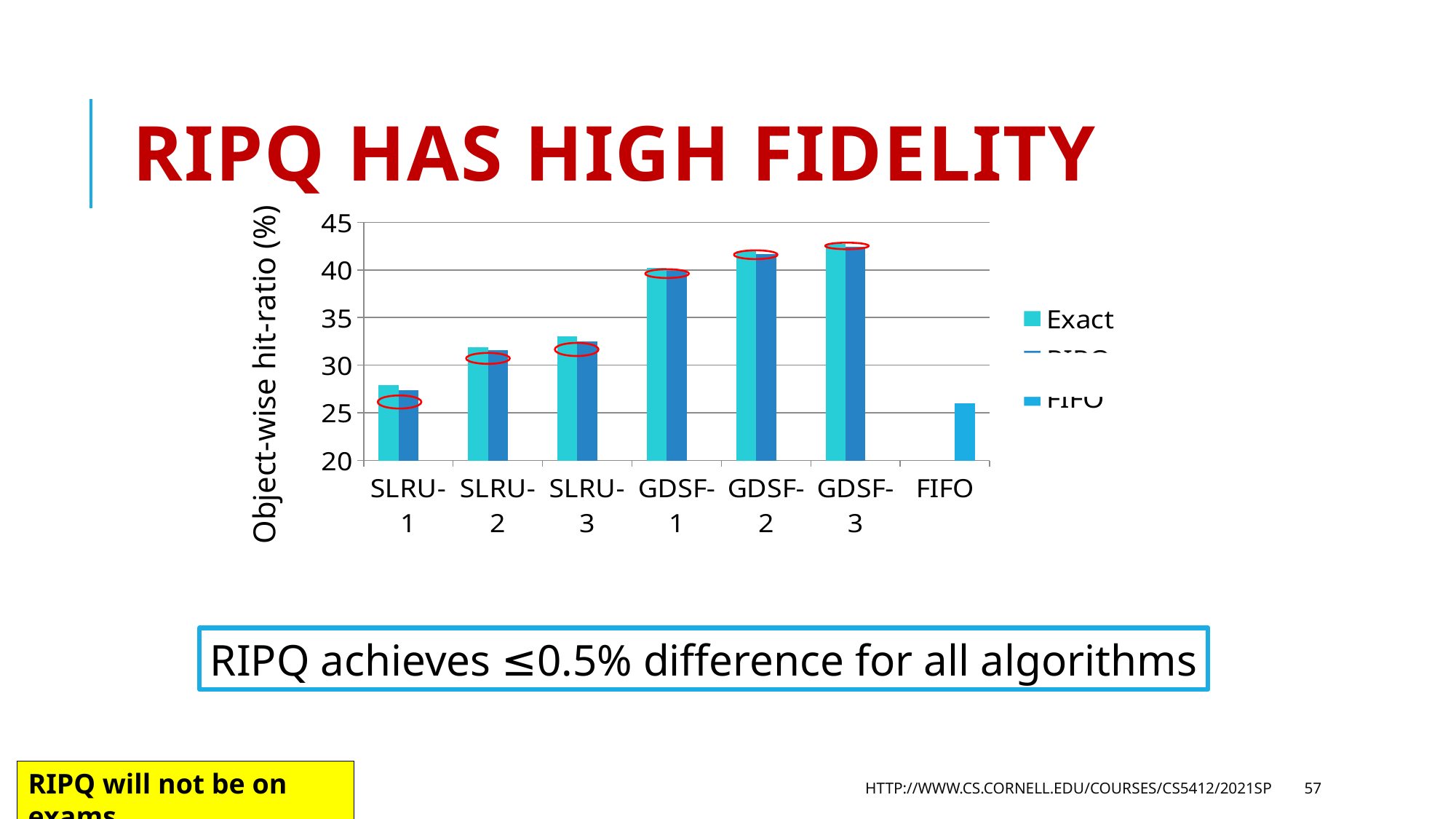
Do the Exact values rise or fall from SLRU-1 to GDSF-3 along the x axis? rise What is the label of the vertical axis of the chart? Object-wise hit-ratio (%) Which has the larger Exact hit-ratio, SLRU-3 or GDSF-1? GDSF-1 How many series does the chart's legend list? 3 Which category has the highest Exact hit-ratio in the chart? GDSF-3 What is the first series named in the chart's legend? Exact Which category has the lowest Exact hit-ratio in the chart? SLRU-1 Is the Exact value for SLRU-1 greater or less than 30? less Is the Exact value for GDSF-3 greater or less than 40? greater Is the value for FIFO greater or less than 30? less What kind of chart is shown on the slide? bar chart How many categories are shown on the x axis of the chart? 7